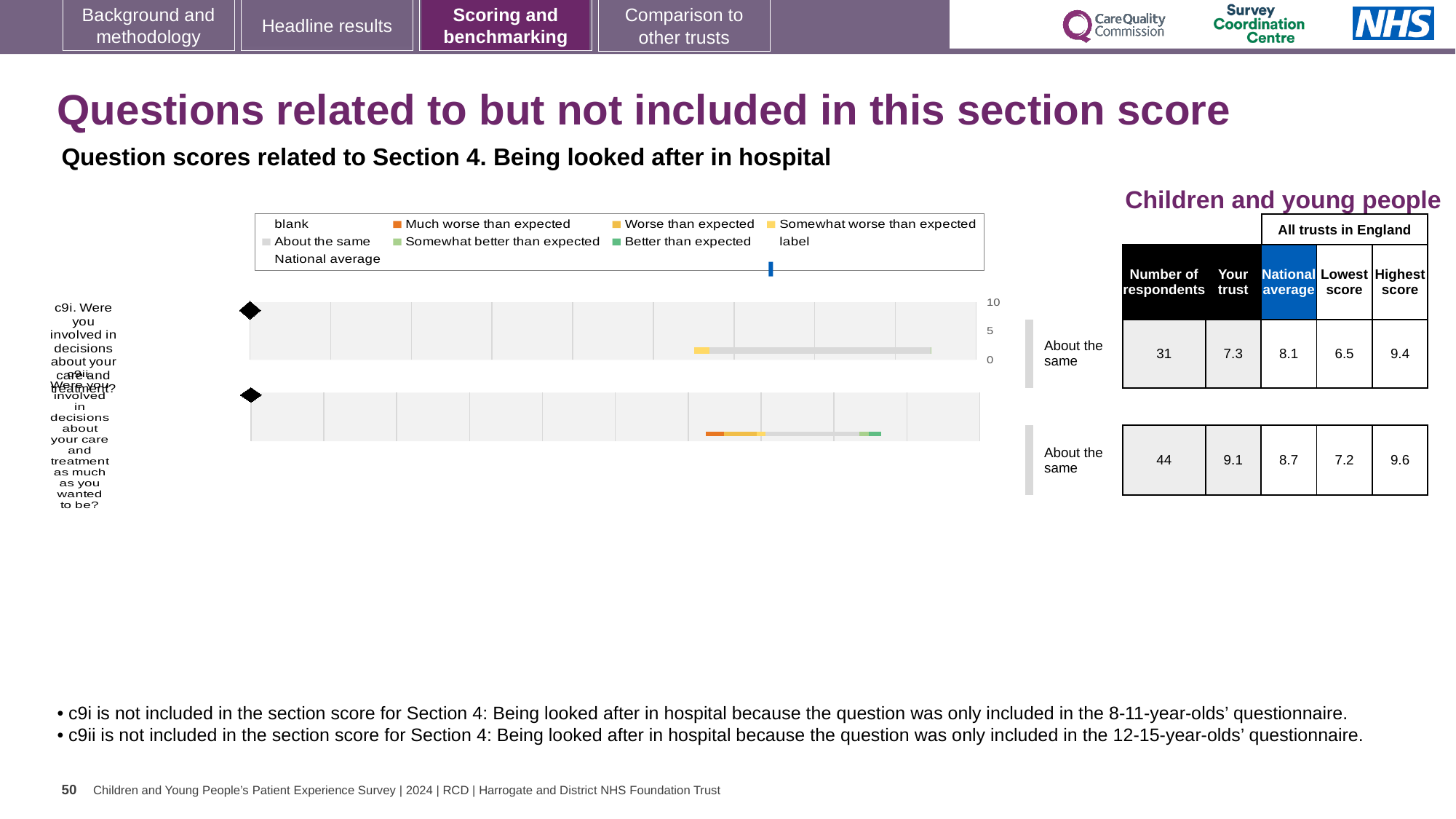
Is the 'Your trust' score for c9i higher or lower than the national average for c9i? lower What is the 'Your trust' score for question c9ii? 9.1 What colour represents 'Much worse than expected' in the chart legend? orange How many respondents answered question c9ii? 44 What is the national average score for question c9i? 8.1 What benchmark category is shown for question c9ii? About the same How many questions are plotted in the chart area (c9i and c9ii)? 2 Which question has the higher 'Your trust' score, c9i or c9ii? c9ii What is the 'Your trust' score for question c9i? 7.3 What kind of chart is used to show the question scores for c9i and c9ii? bar chart What is the difference between the highest score and the lowest score across all trusts in England for question c9i? 2.9 What is the national average score for question c9ii? 8.7